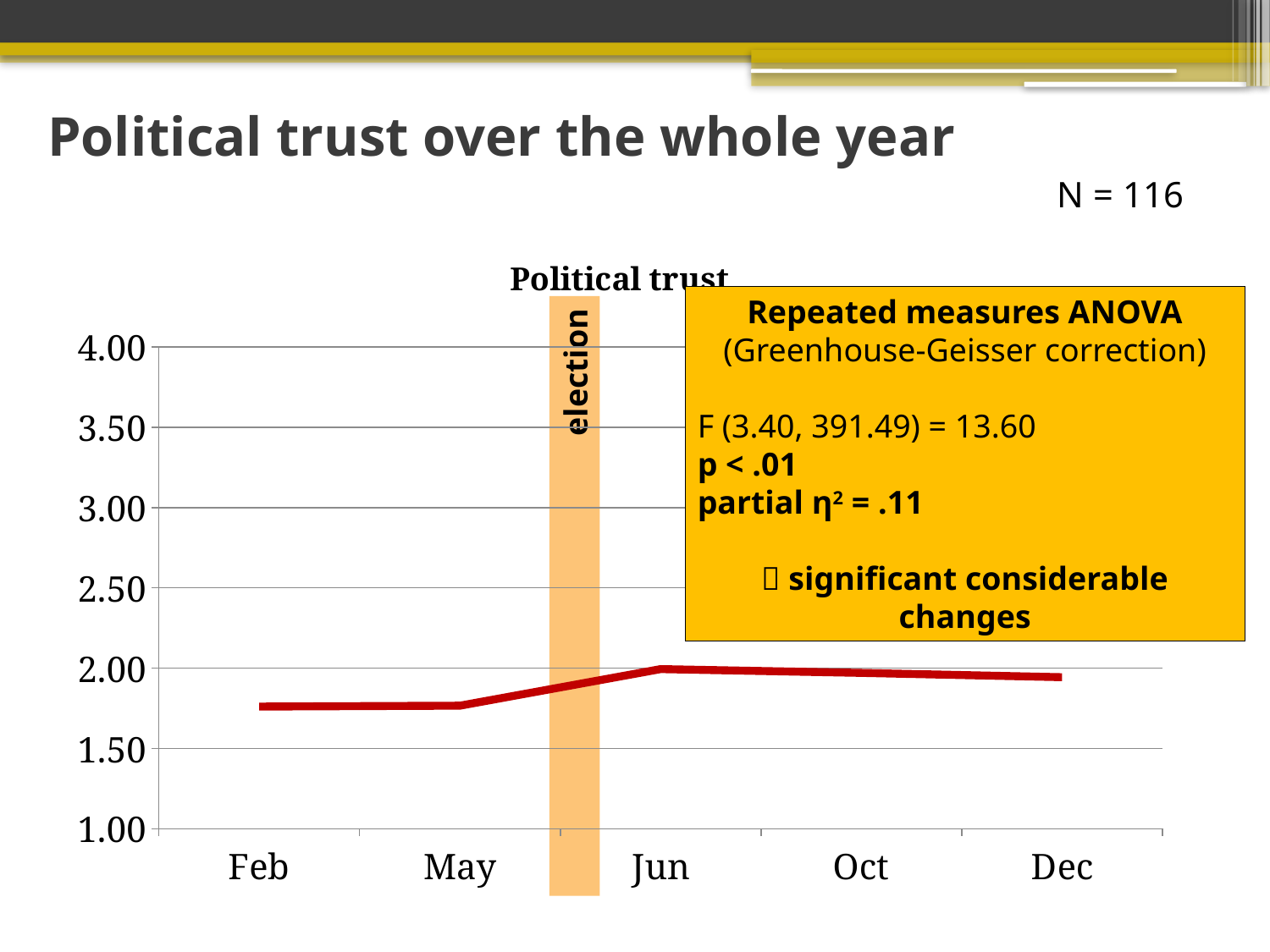
What is the lowest value shown on the y axis? 1.00 How many time points are plotted along the x axis? 5 Between which two x-axis labels is the 'election' marker placed? May and Jun Is the value for Oct greater or less than 2.50? less What kind of chart is shown on the slide? line chart Does political trust rise or fall between May and Jun? rise Is the value for May greater or less than 1.50? greater What is the title of the chart? Political trust Is the value for Feb greater or less than 2.00? less Which is larger, the value for Jun or the value for Feb? Jun Which is larger, the value for May or the value for Oct? Oct